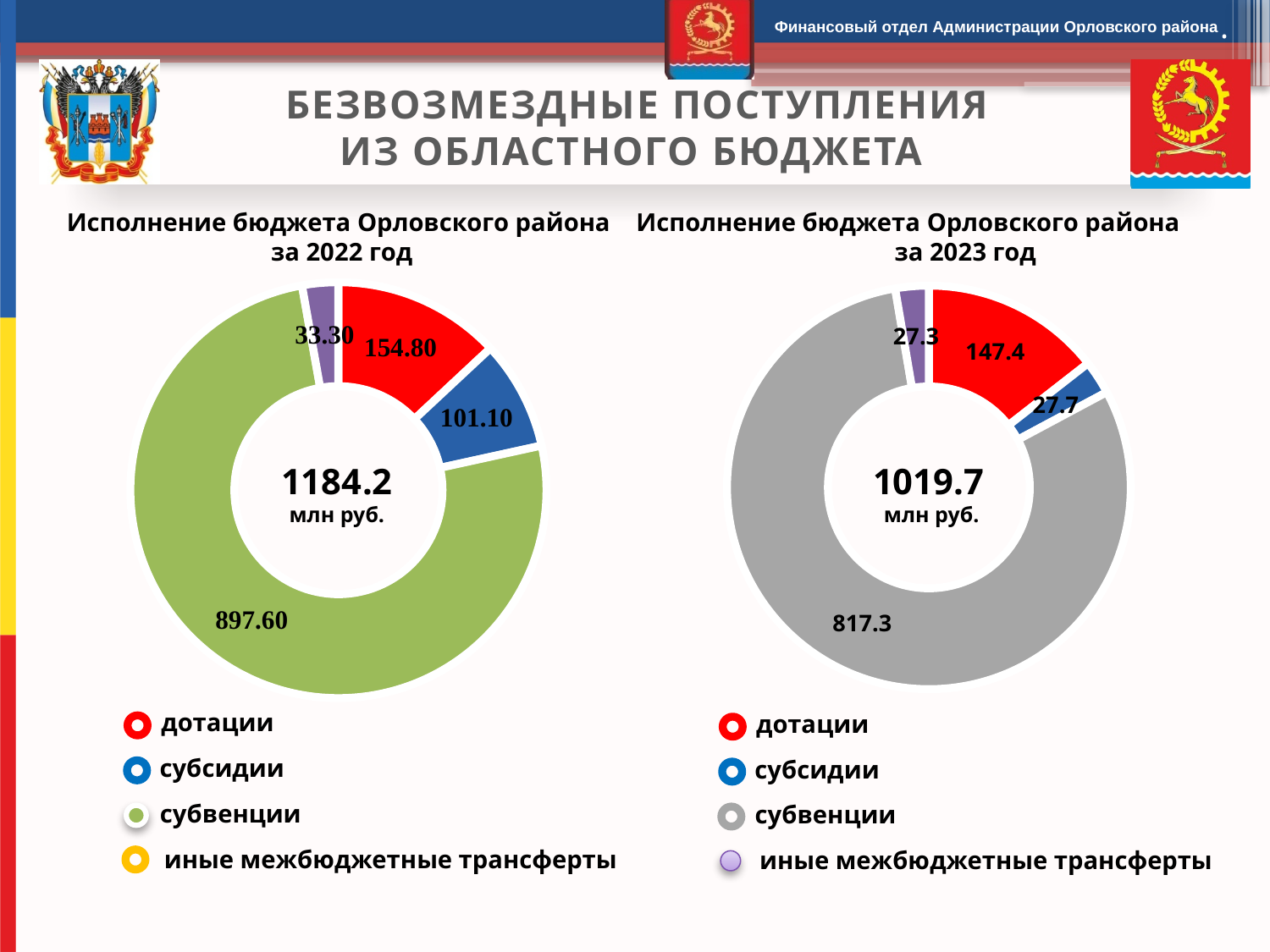
What kind of chart is 'Исполнение бюджета Орловского района за 2022 год'? Pie (donut) chart In the chart 'Исполнение бюджета Орловского района за 2022 год', what is the value for субсидии? 101.10 In the chart 'Исполнение бюджета Орловского района за 2022 год', what is the difference between дотации and субсидии? 53.70 In the chart 'Исполнение бюджета Орловского района за 2022 год', what colour is the slice for дотации? Red In the chart 'Исполнение бюджета Орловского района за 2023 год', what is the value for субвенции? 817.3 In the chart 'Исполнение бюджета Орловского района за 2022 год', what is the value for субвенции? 897.60 In the chart 'Исполнение бюджета Орловского района за 2023 год', what is the value for дотации? 147.4 In the chart 'Исполнение бюджета Орловского района за 2022 год', which category has the largest value? субвенции How many categories does the chart 'Исполнение бюджета Орловского района за 2023 год' show? 4 In the chart 'Исполнение бюджета Орловского района за 2023 год', which is larger: дотации or субсидии? дотации What total is shown in the centre of the chart 'Исполнение бюджета Орловского района за 2023 год'? 1019.7 млн руб. In the chart 'Исполнение бюджета Орловского района за 2023 год', which category has the smallest value? иные межбюджетные трансферты